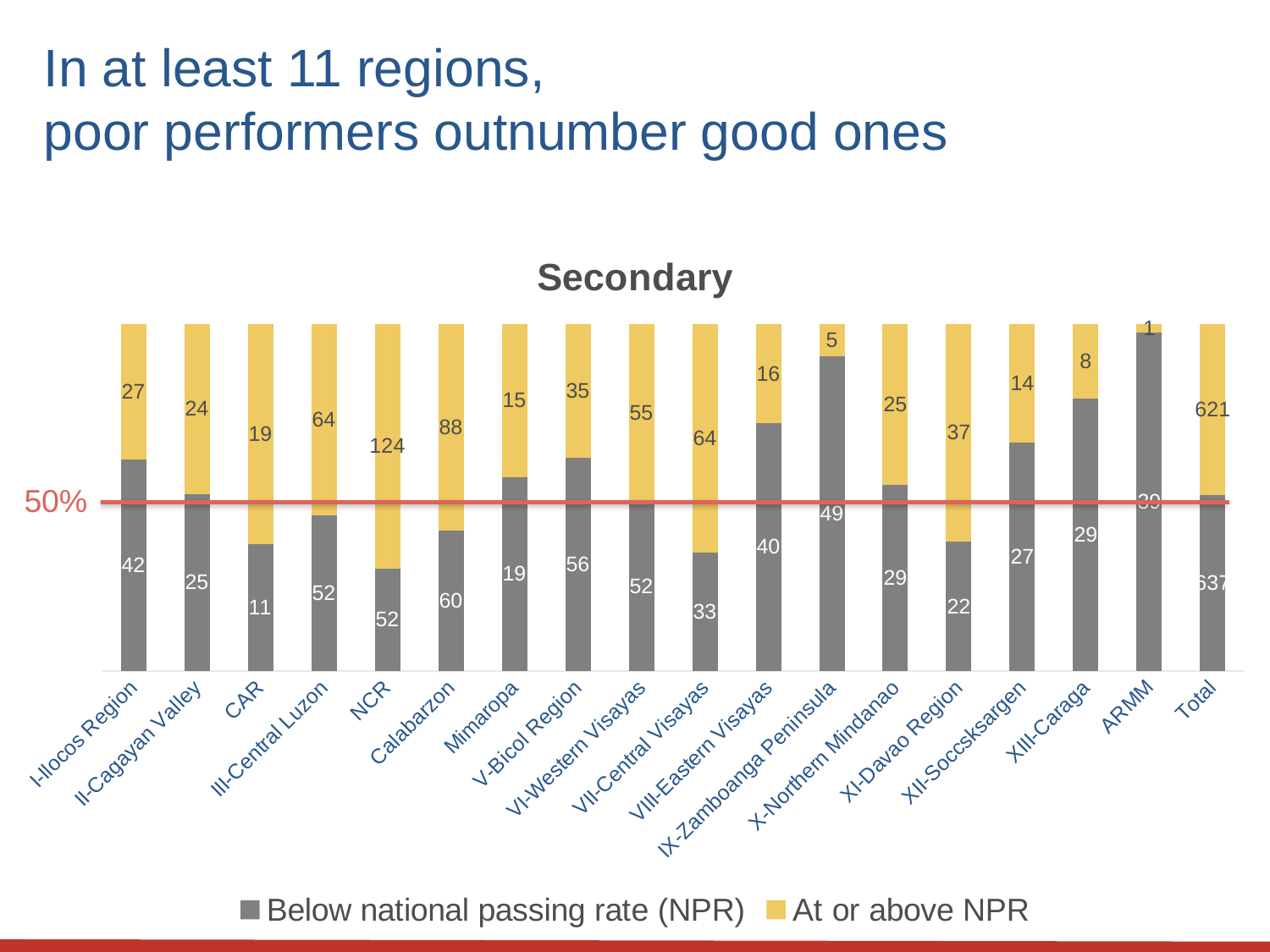
How many series does the legend list? 2 What is the combined total of the two segments for III-Central Luzon? 116 Which region has the lowest 'At or above NPR' value? ARMM Excluding the Total bar, which region has the highest 'At or above NPR' value? NCR What is the 'Below national passing rate (NPR)' value for IX-Zamboanga Peninsula? 49 What is the value for 'At or above NPR' for Calabarzon? 88 How many categories are shown on the x axis, including Total? 18 What is the 'At or above NPR' value for the Total bar? 621 What is the title of the chart? Secondary For V-Bicol Region, which is larger: the 'Below national passing rate (NPR)' value or the 'At or above NPR' value? Below national passing rate (NPR) What is the difference between the 'At or above NPR' and 'Below national passing rate (NPR)' values for NCR? 72 What is the value for 'Below national passing rate (NPR)' for NCR? 52